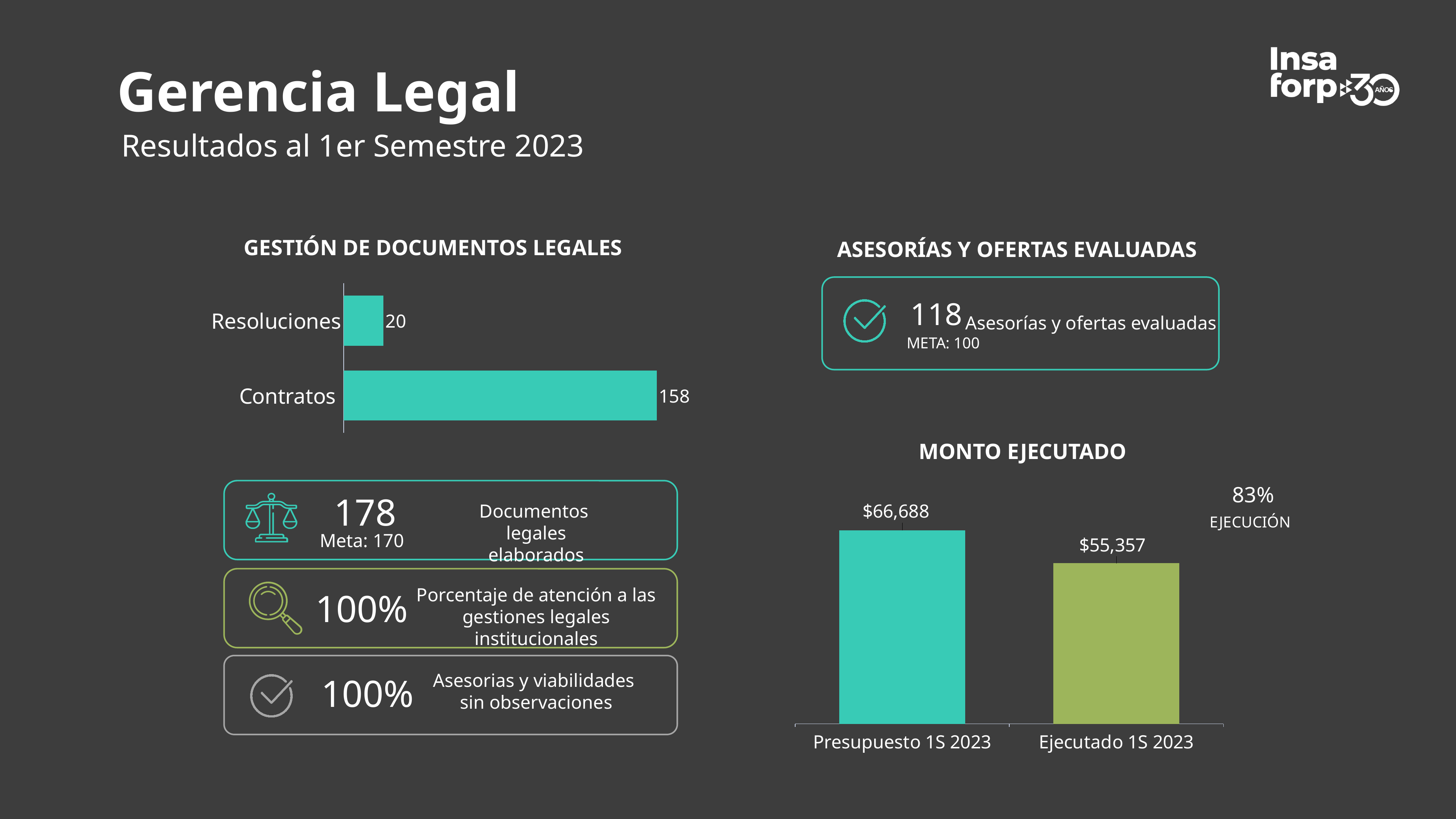
In the GESTIÓN DE DOCUMENTOS LEGALES chart, what is the difference between Contratos and Resoluciones? 138 In the MONTO EJECUTADO chart, what is the value for Ejecutado 1S 2023? $55,357 In the MONTO EJECUTADO chart, what is the value for Presupuesto 1S 2023? $66,688 In the MONTO EJECUTADO chart, which is larger: Presupuesto 1S 2023 or Ejecutado 1S 2023? Presupuesto 1S 2023 In the GESTIÓN DE DOCUMENTOS LEGALES chart, which category has the highest value? Contratos In the GESTIÓN DE DOCUMENTOS LEGALES chart, what is the value for Resoluciones? 20 In the MONTO EJECUTADO chart, what percentage of execution is shown next to the bars? 83% In the GESTIÓN DE DOCUMENTOS LEGALES chart, what is the value for Contratos? 158 What kind of chart is the GESTIÓN DE DOCUMENTOS LEGALES chart? Bar chart In the MONTO EJECUTADO chart, which category has the lowest value? Ejecutado 1S 2023 In the GESTIÓN DE DOCUMENTOS LEGALES chart, how many categories are shown? 2 In the MONTO EJECUTADO chart, what is the difference between Presupuesto 1S 2023 and Ejecutado 1S 2023? $11,331